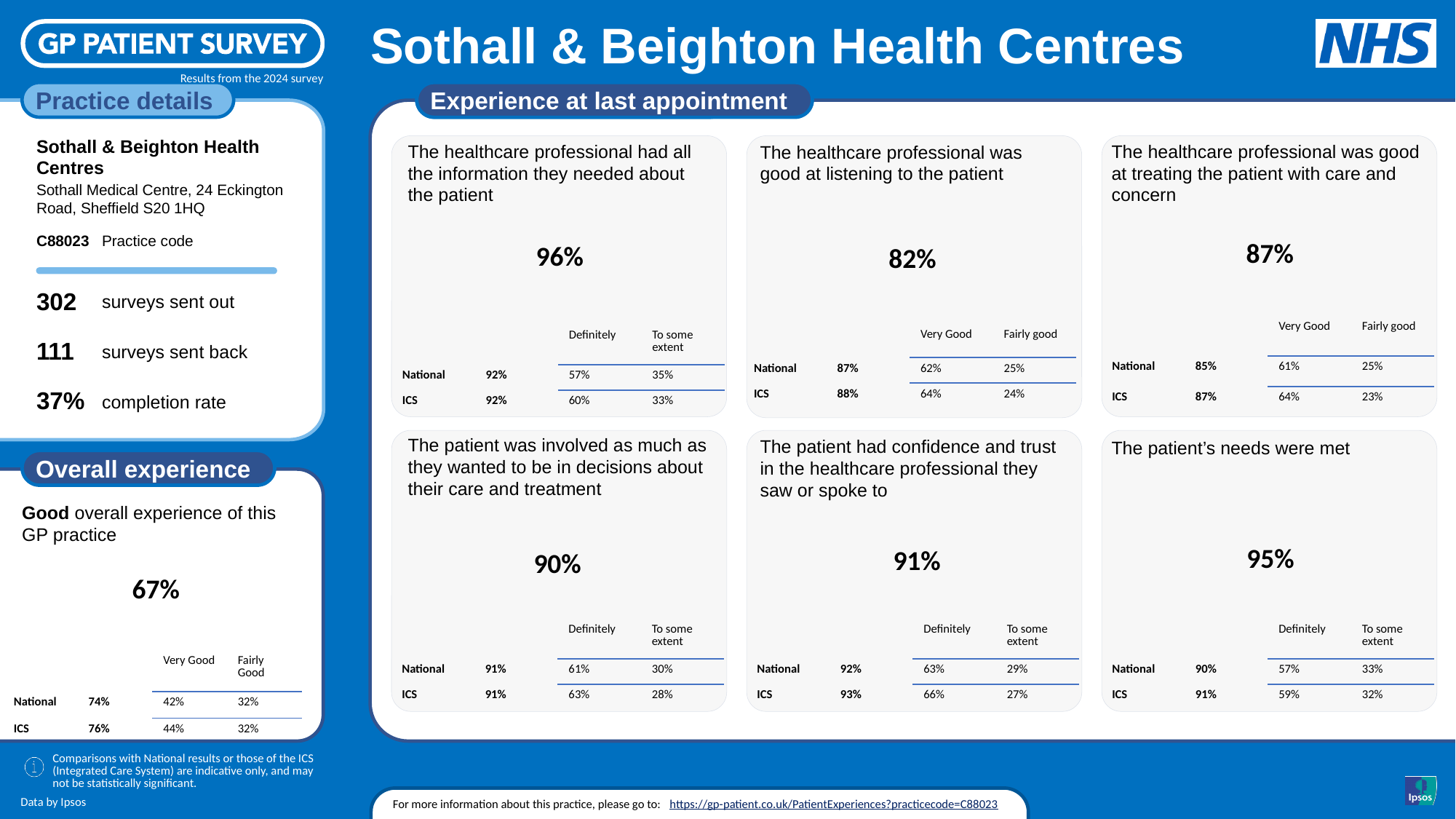
How many statement panels are shown in the 'Experience at last appointment' section? 6 In the 'The healthcare professional was good at listening to the patient' panel, what is the difference between the ICS value and the practice value? 6% In the 'Overall experience' panel, what percentage of patients reported a good overall experience of this GP practice? 67% In the 'Experience at last appointment' section, what percentage is shown for 'The healthcare professional was good at listening to the patient'? 82% Among the six 'Experience at last appointment' panels, which statement has the lowest practice percentage? The healthcare professional was good at listening to the patient In the 'The patient had confidence and trust in the healthcare professional they saw or spoke to' panel, what is the National 'Definitely' value? 63% In the 'Experience at last appointment' section, what percentage is shown for 'The healthcare professional had all the information they needed about the patient'? 96% In the 'Overall experience' panel, what is the National value for good overall experience? 74% Among the six 'Experience at last appointment' panels, which statement has the highest practice percentage? The healthcare professional had all the information they needed about the patient In the 'Overall experience' panel, which is larger: the practice value or the National value? National In the 'The patient's needs were met' panel, what is the ICS value? 91% In the 'Overall experience' panel, what is the ICS 'Very Good' value? 44%